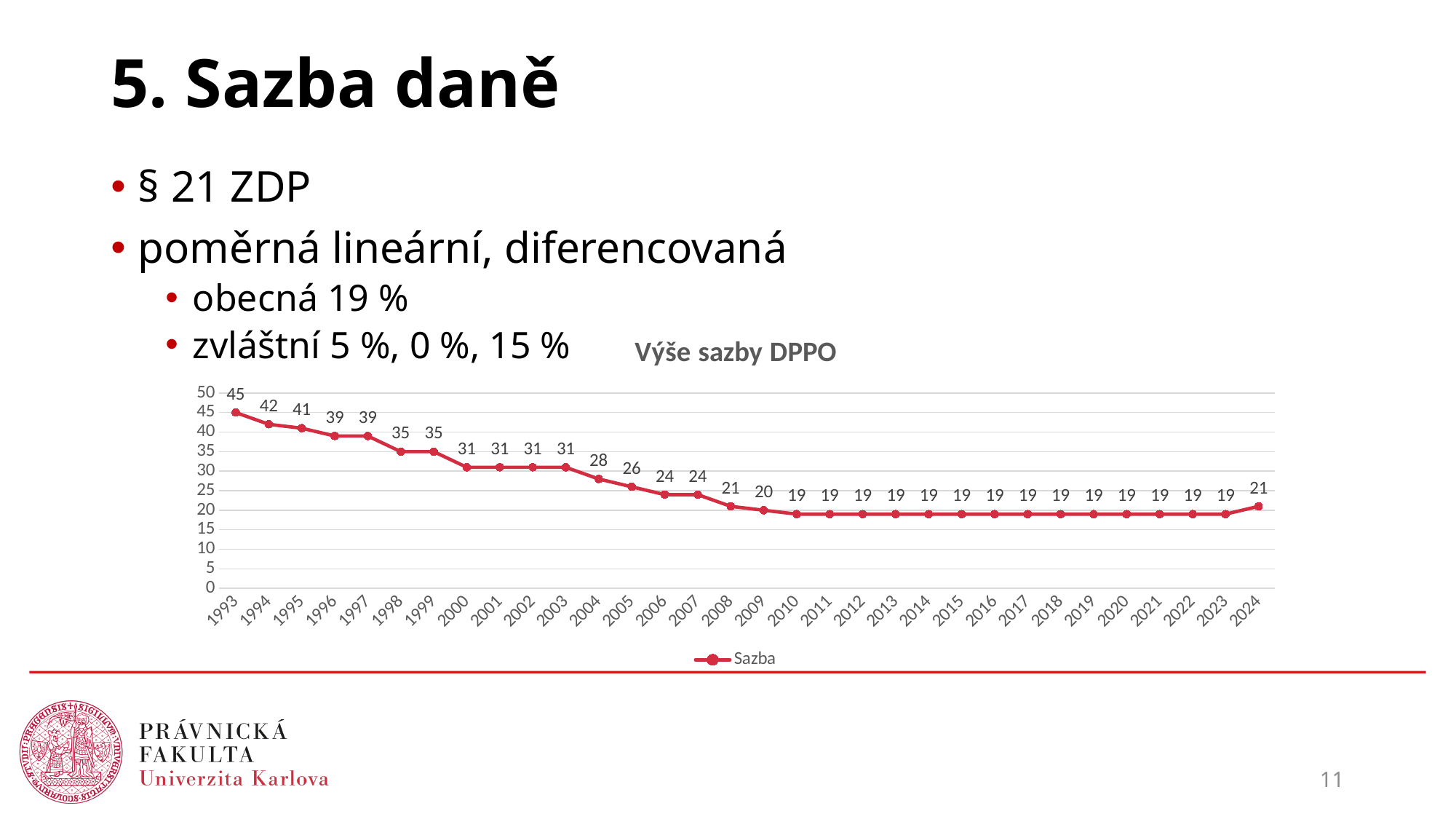
What is the value for 2004 in the chart? 28 What is the value for 2024 in the chart? 21 How many series does the chart legend list? 1 How many years are plotted on the x axis of the chart? 32 What is the value for 1993 in the chart? 45 What kind of chart is shown on the slide? line chart What is the title of the chart? Výše sazby DPPO What is the difference between the values for 2003 and 2004? 3 Is the value for 2000 greater or less than 25? greater Which is larger, the value for 1998 or the value for 2006? 1998 Which year has the highest value in the chart? 1993 What is the difference between the values for 1993 and 2023? 26